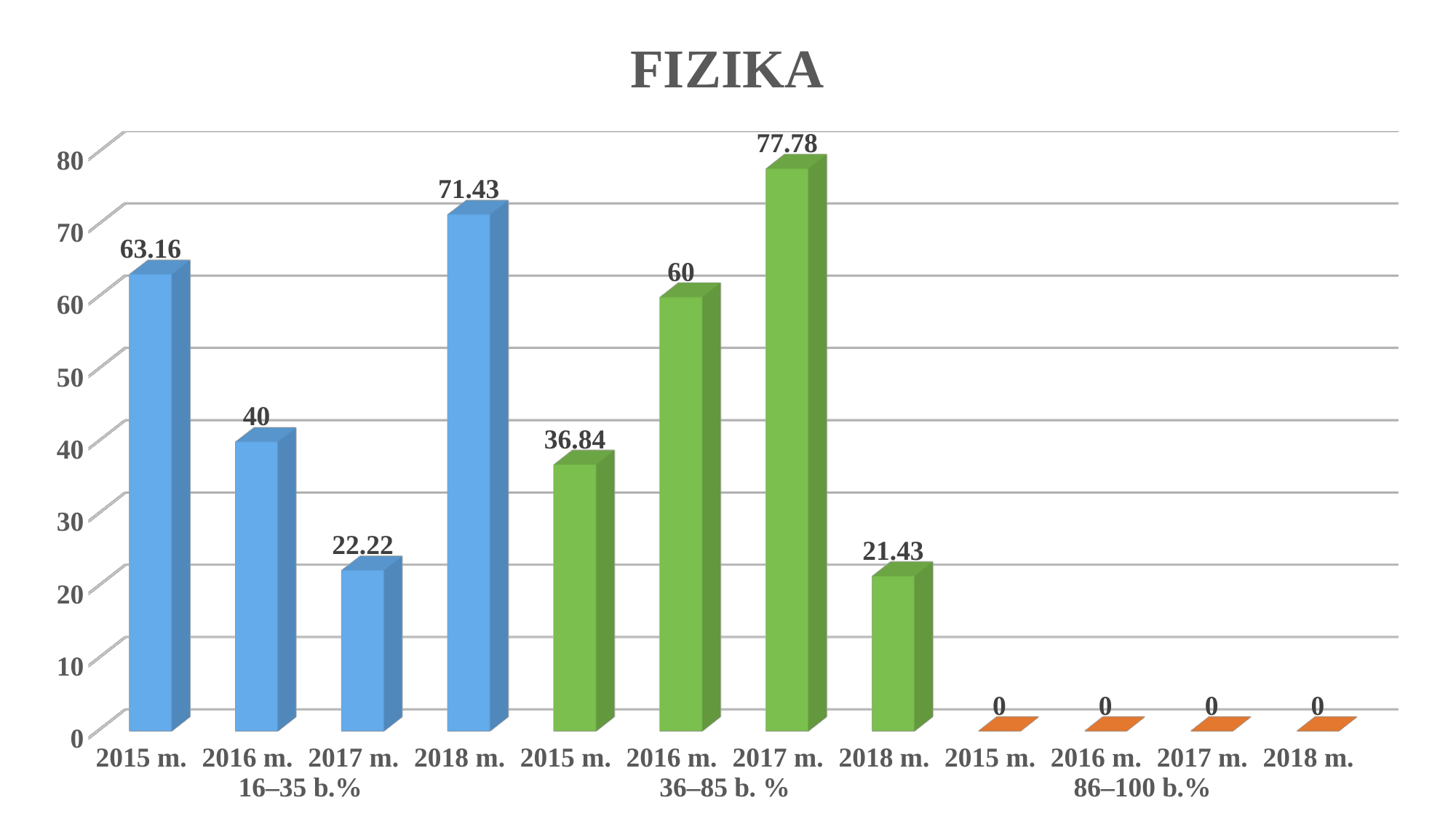
What is the value for 2018 m. in the 36–85 b. % group? 21.43 What is the title of the chart? FIZIKA Which bar has the highest value on the chart? 2017 m. in the 36–85 b. % group (77.78) What is the value for 2016 m. in the 86–100 b.% group? 0 What is the value for 2015 m. in the 16–35 b.% group? 63.16 Within the 16–35 b.% group, which year has the lowest value? 2017 m. Which is larger: the 2016 m. value in the 16–35 b.% group or the 2016 m. value in the 36–85 b. % group? 36–85 b. % group (60) What is the value for 2017 m. in the 36–85 b. % group? 77.78 How many bars are in the 86–100 b.% group? 4 What is the difference between the 2018 m. and 2017 m. values in the 16–35 b.% group? 49.21 What kind of chart is shown on the slide? bar chart How many bars are plotted on the chart? 12